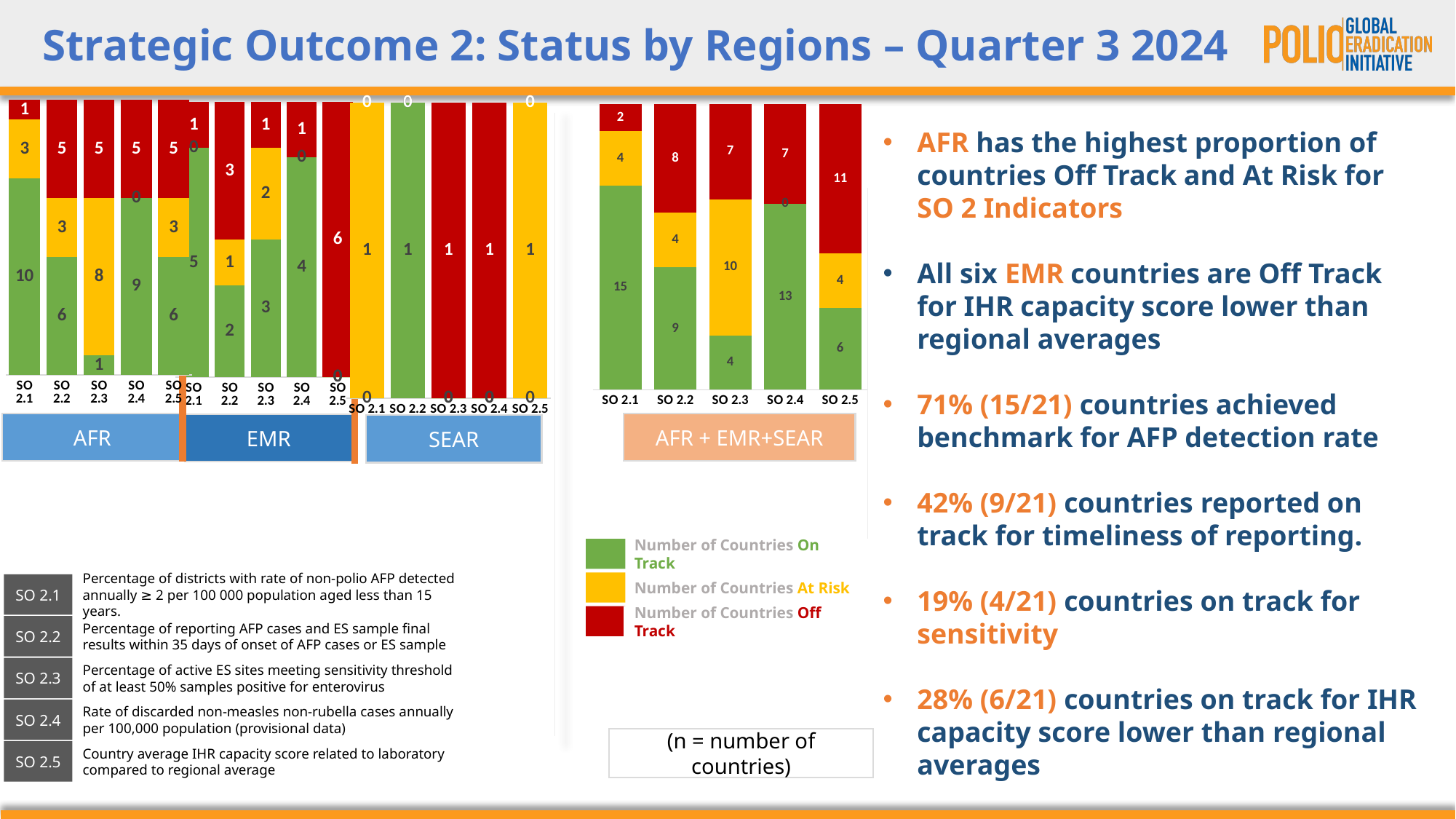
In the AFR + EMR+SEAR chart, which indicator has the highest number of countries On Track? SO 2.1 In the AFR + EMR+SEAR chart, which indicator has the lowest number of countries On Track? SO 2.3 In the AFR + EMR+SEAR chart, how many countries are On Track for SO 2.1? 15 In the AFR + EMR+SEAR chart, how many countries are At Risk for SO 2.3? 10 In the AFR chart, which is larger: the number of countries On Track for SO 2.1 or for SO 2.2? SO 2.1 In the EMR chart, how many countries are Off Track for SO 2.5? 6 In the AFR + EMR+SEAR chart, what is the total number of countries for SO 2.2 across all three statuses? 21 What kind of chart is the AFR + EMR+SEAR chart? Stacked bar chart In the AFR + EMR+SEAR chart, how many countries are Off Track for SO 2.5? 11 In the AFR + EMR+SEAR chart, what is the difference between the number of countries On Track for SO 2.4 and for SO 2.5? 7 How many series does the legend list for the charts? 3 In the AFR chart, how many countries are At Risk for SO 2.3? 8